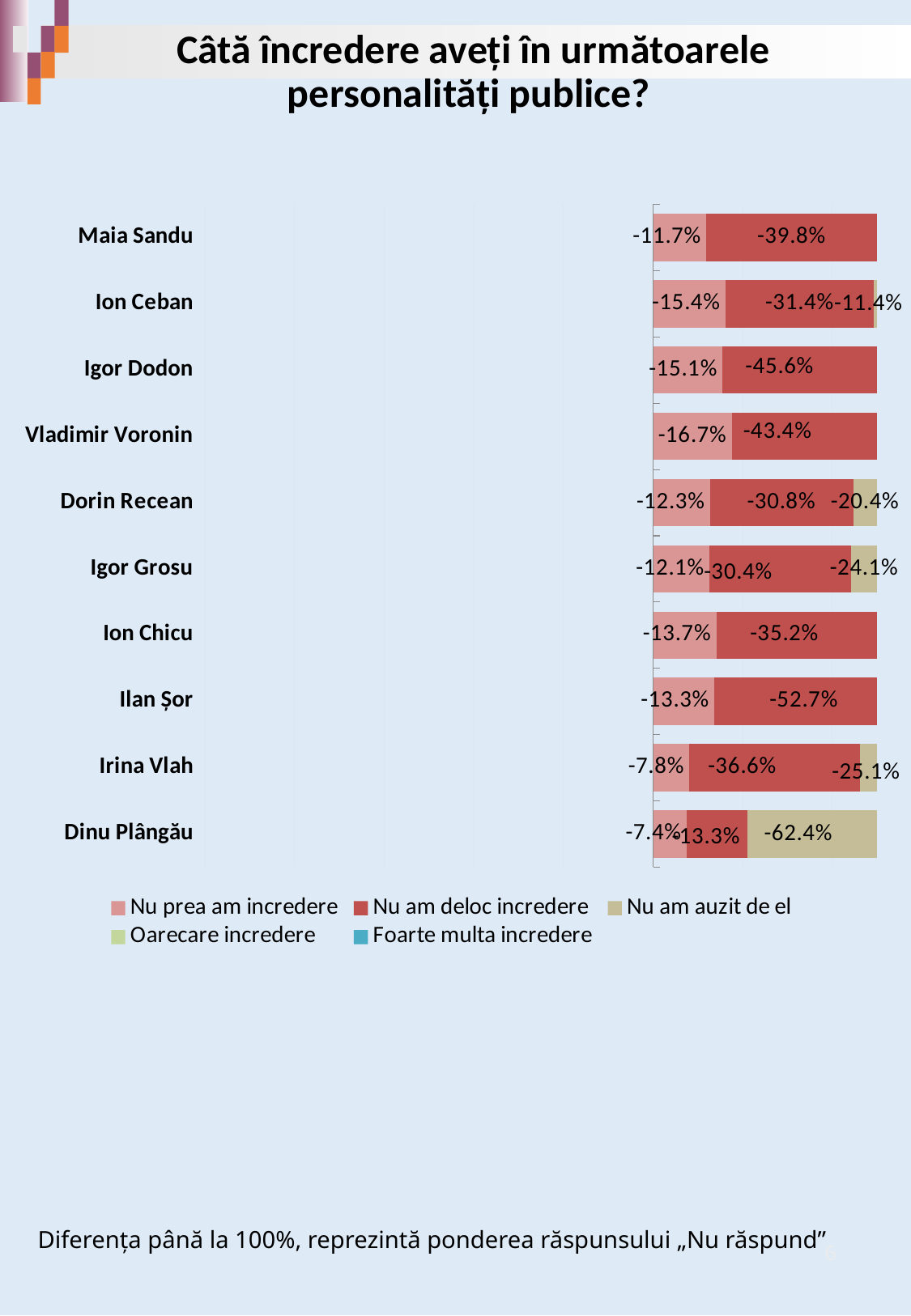
What is the value labelled for "Nu am deloc incredere" for Ilan Șor? -52.7% What type of chart is shown on the slide? Stacked bar chart Which legend entry is shown in the tan/beige colour? Nu am auzit de el What is the value labelled for "Nu am auzit de el" for Dinu Plângău? -62.4% What is the difference in magnitude between the "Nu am deloc incredere" values for Igor Dodon (-45.6%) and Maia Sandu (-39.8%)? 5.8% How many public personalities are listed on the chart? 10 Which personality has the shortest "Nu am deloc incredere" segment? Dinu Plângău Which personality has the longest "Nu am deloc incredere" segment? Ilan Șor Which is larger in magnitude: the "Nu am deloc incredere" value for Igor Dodon or for Ion Chicu? Igor Dodon What is the value labelled for "Nu prea am incredere" for Vladimir Voronin? -16.7% What is the value labelled for "Nu am deloc incredere" for Maia Sandu? -39.8% How many series does the legend list? 5